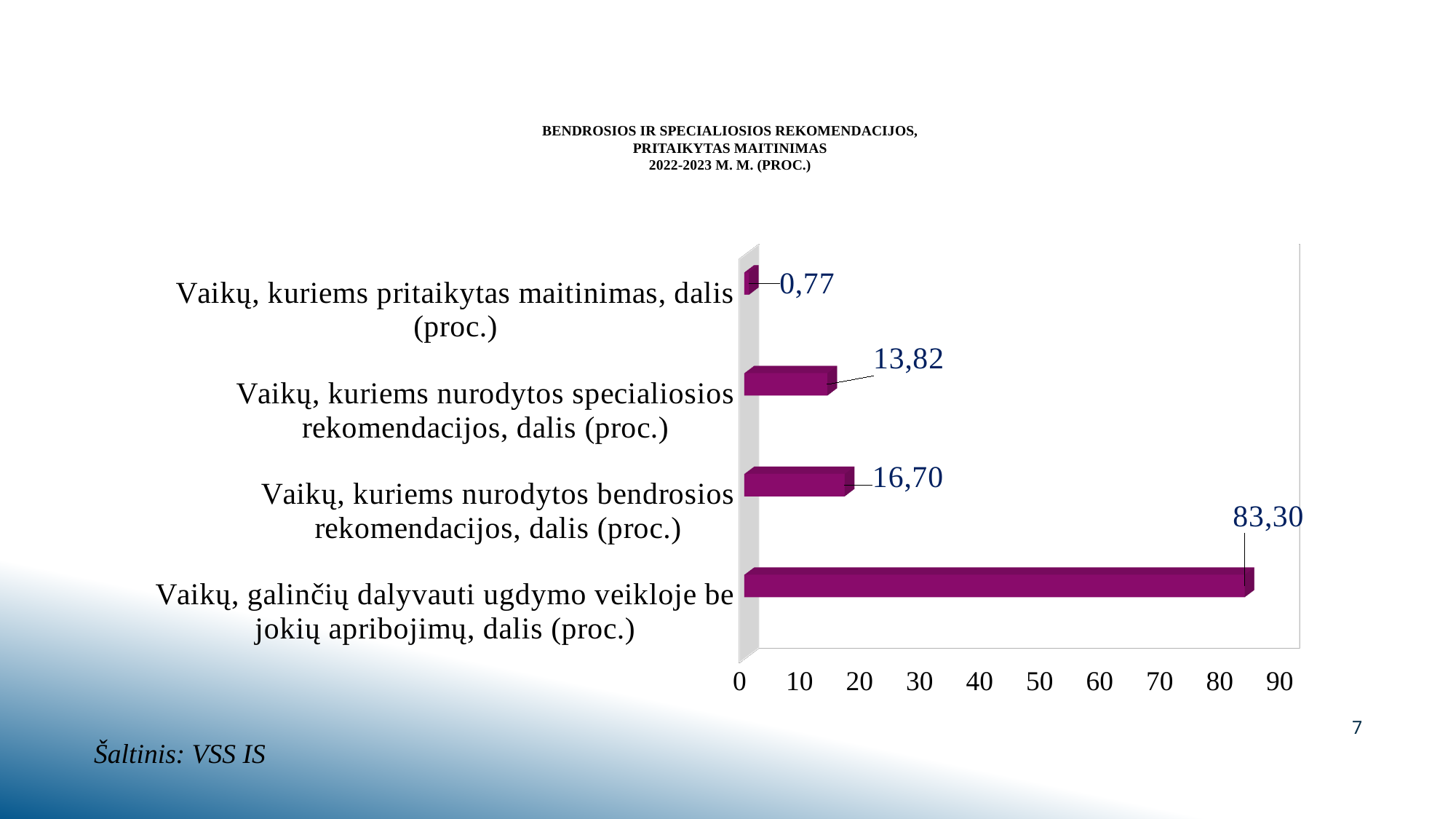
What is the value for "Vaikų, kuriems pritaikytas maitinimas, dalis (proc.)"? 0,77 What is the value for "Vaikų, galinčių dalyvauti ugdymo veikloje be jokių apribojimų, dalis (proc.)"? 83,30 Which category has the lowest value? Vaikų, kuriems pritaikytas maitinimas, dalis (proc.) Which is larger: the value for children with general recommendations (bendrosios) or the value for children with special recommendations (specialiosios)? Vaikų, kuriems nurodytos bendrosios rekomendacijos, dalis (proc.) What is the value for "Vaikų, kuriems nurodytos bendrosios rekomendacijos, dalis (proc.)"? 16,70 Which category has the highest value? Vaikų, galinčių dalyvauti ugdymo veikloje be jokių apribojimų, dalis (proc.) What is the value for "Vaikų, kuriems nurodytos specialiosios rekomendacijos, dalis (proc.)"? 13,82 What is the difference between the value for children able to participate without restrictions and the value for children with general recommendations? 66,60 What kind of chart is shown on the slide? Bar chart What source is cited for the chart data? VSS IS How many categories are shown in the chart? 4 What is the difference between the value for children with general recommendations (bendrosios rekomendacijos) and children with special recommendations (specialiosios rekomendacijos)? 2,88